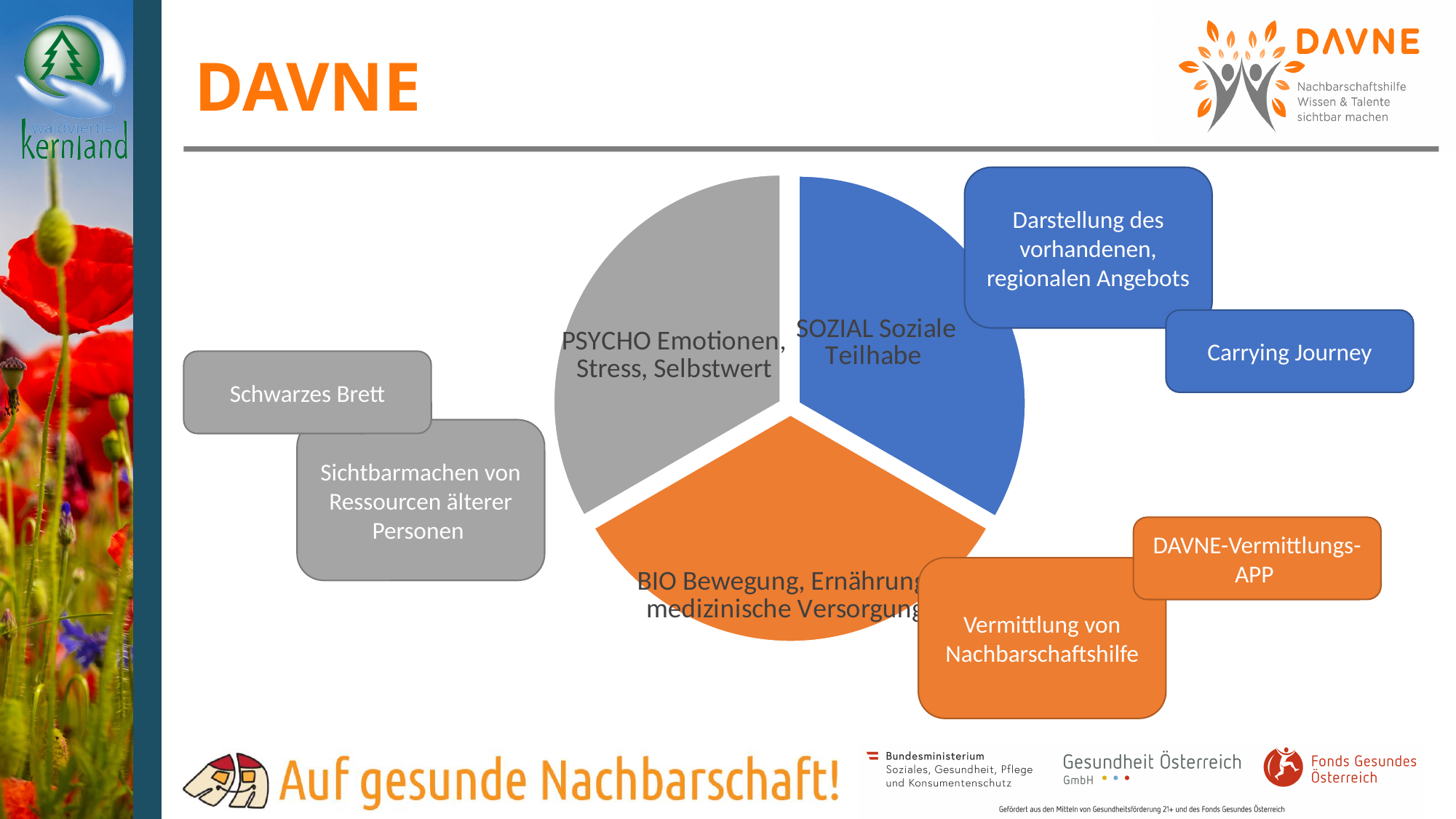
Which slice of the pie chart is labelled with 'Soziale Teilhabe'? SOZIAL Which slice of the pie chart is labelled with 'Emotionen, Stress, Selbstwert'? PSYCHO Which slice of the pie chart is coloured orange? BIO Bewegung, Ernährung, medizinische Versorgung What kind of chart is shown on the slide? pie chart Which slice of the pie chart is coloured blue? SOZIAL Soziale Teilhabe How many slices does the pie chart have? 3